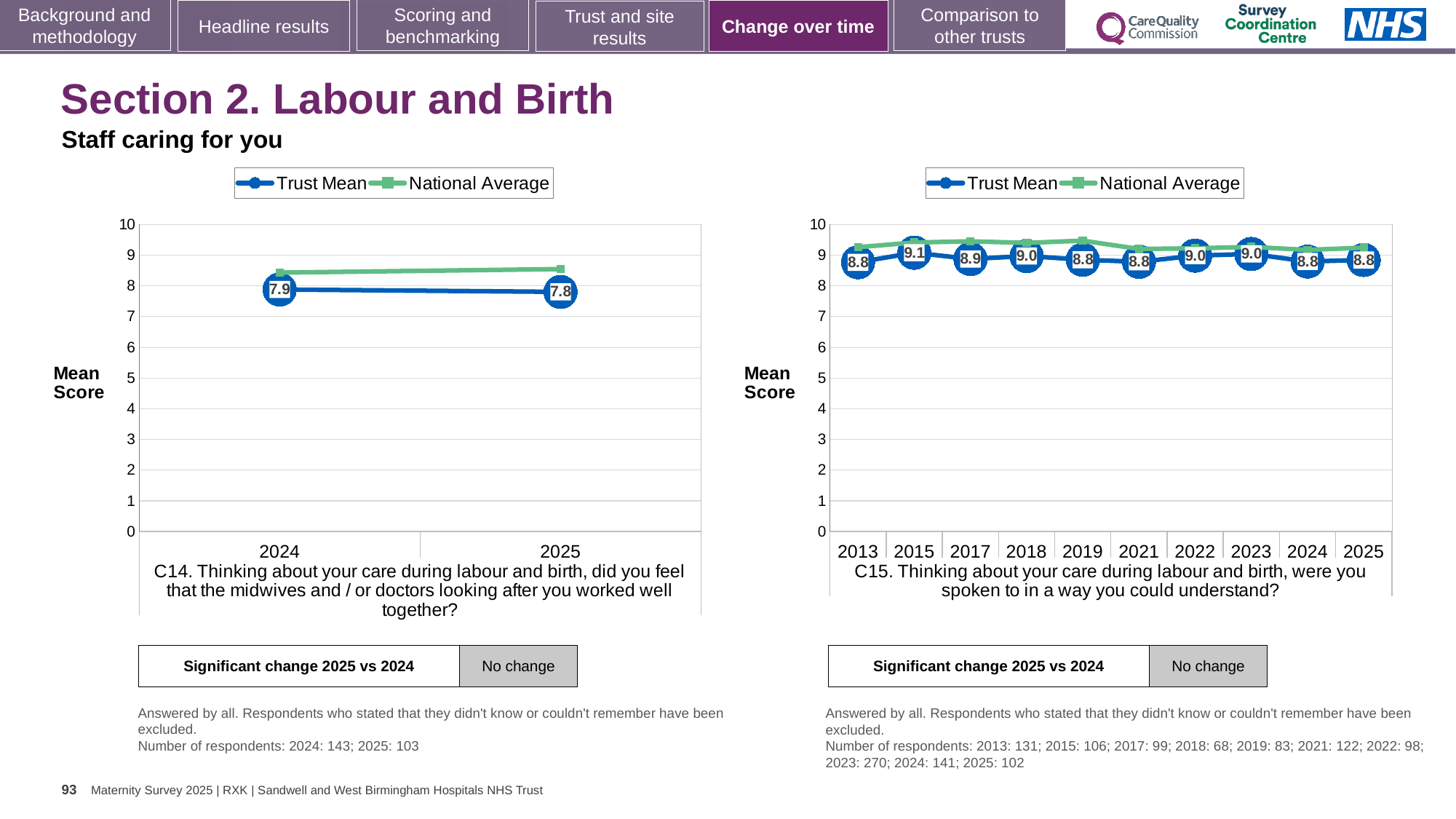
How many series does the legend of the right chart (C15) list? 2 In the right chart (C15), what is the Trust Mean for 2025? 8.8 In the left chart (C14), what is the Trust Mean for 2025? 7.8 In the left chart (C14), what is the Trust Mean for 2024? 7.9 In the right chart (C15), how many years are plotted on the x axis? 10 In the right chart (C15), what is the Trust Mean for 2015? 9.1 In the right chart (C15), which is larger, the Trust Mean for 2015 or for 2017? 2015 In the left chart (C14), does the Trust Mean rise or fall from 2024 to 2025? fall In the left chart (C14), is the National Average for 2025 greater or less than 8? greater What kind of chart is the left chart (C14)? line chart In the left chart (C14), what is the difference between the Trust Mean for 2024 and 2025? 0.1 In the right chart (C15), which year has the highest Trust Mean? 2015